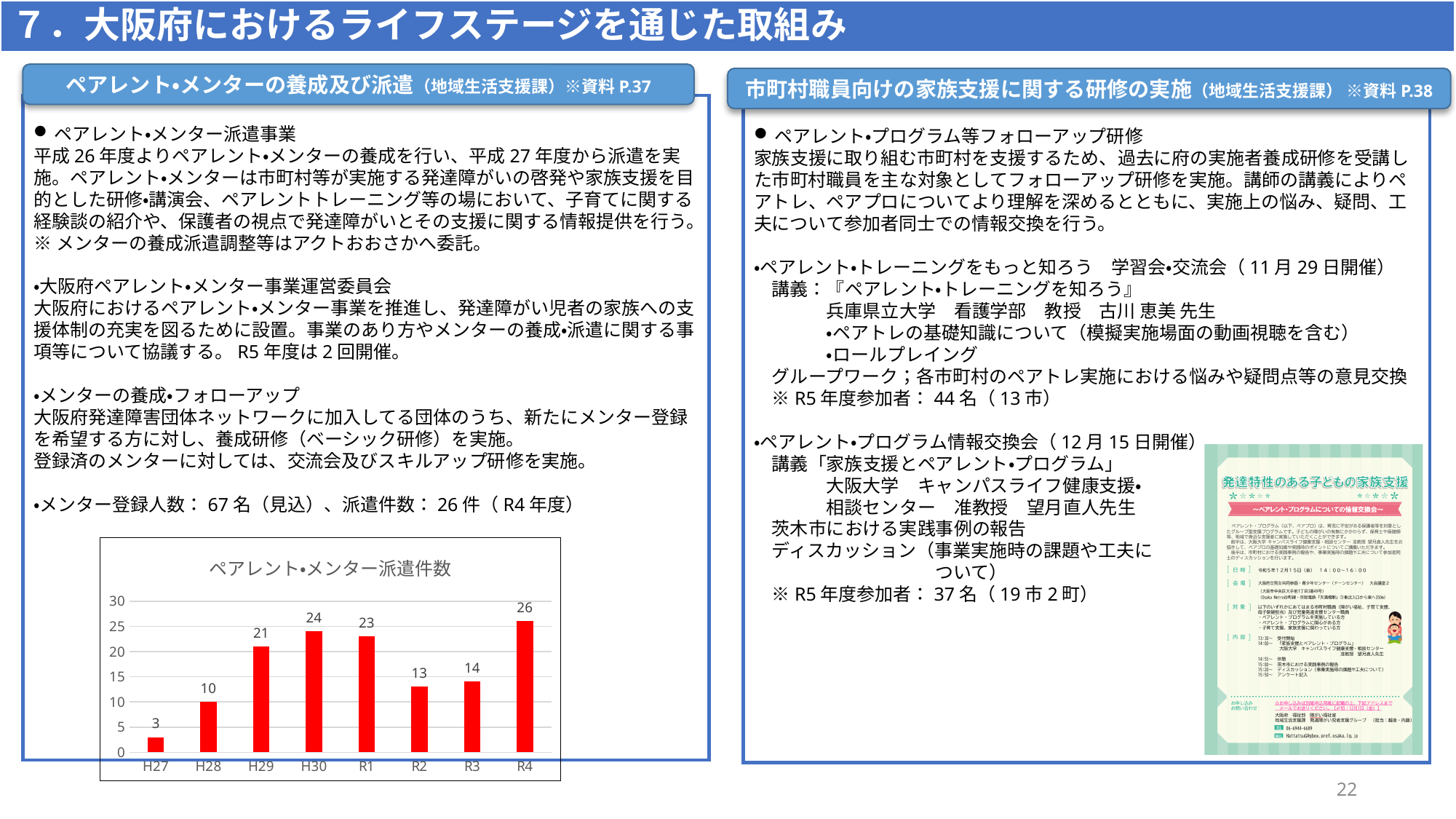
Is the value for H28 greater or less than 15? less Do the values rise or fall from H27 to H30? rise What type of chart is shown on the slide? bar chart What is the value for H27 in the chart? 3 What is the difference between the values for R4 and R3? 12 Which category has the highest value in the chart? R4 What is the value for H30 in the chart? 24 How many categories are shown on the x axis of the chart? 8 Which category has the lowest value in the chart? H27 What is the title of the chart on the slide? ペアレント•メンター派遣件数 What is the value for R2 in the chart? 13 Which is larger, the value for H29 or the value for R1? R1